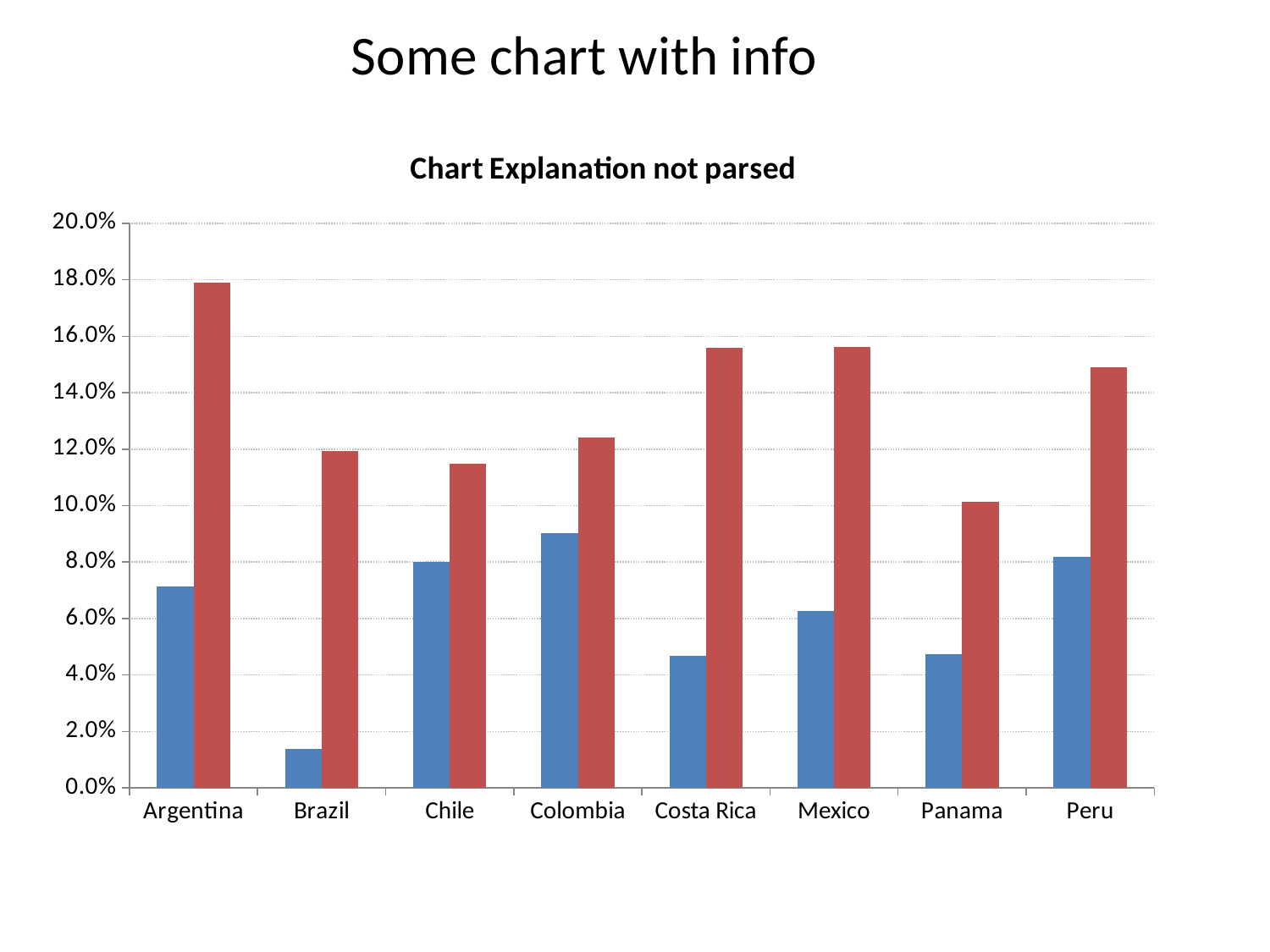
What is the title of the chart? Chart Explanation not parsed Which is larger, the red bar for Brazil or the red bar for Argentina? Argentina Is the blue bar for Brazil greater or less than 2.0%? less How many countries are shown on the x axis of the chart? 8 Which country has the lowest red bar? Panama Is the red bar for Argentina greater or less than 16.0%? greater Which country has the lowest blue bar? Brazil Is the red bar for Peru greater or less than 16.0%? less What kind of chart is shown on the slide? bar chart Which country has the highest red bar? Argentina Which country has the highest blue bar? Colombia Which is larger, the blue bar for Chile or the blue bar for Costa Rica? Chile